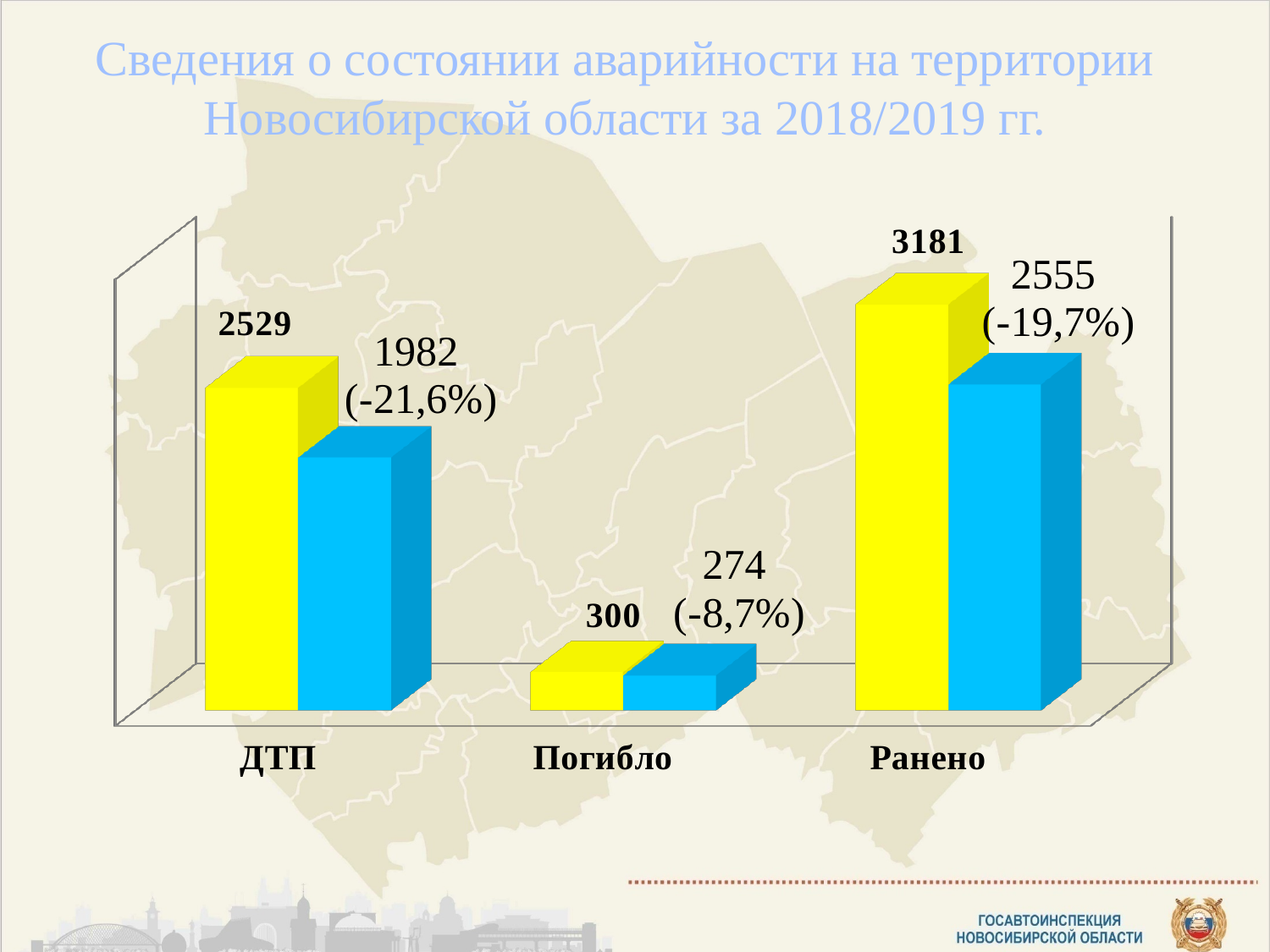
What value is shown on the yellow bar for Погибло? 300 What value is shown on the yellow bar for Ранено? 3181 What value is shown on the yellow bar for ДТП? 2529 What value is shown on the blue bar for ДТП? 1982 What value is shown on the blue bar for Ранено? 2555 Which category has the lowest blue bar? Погибло What value is shown on the blue bar for Погибло? 274 What percentage change is printed next to the blue bar for Погибло? (-8,7%) Which is larger for Ранено, the yellow bar or the blue bar? the yellow bar How many categories are shown on the x axis? 3 Which category has the highest yellow bar? Ранено What is the difference between the yellow and blue bar values for ДТП? 547